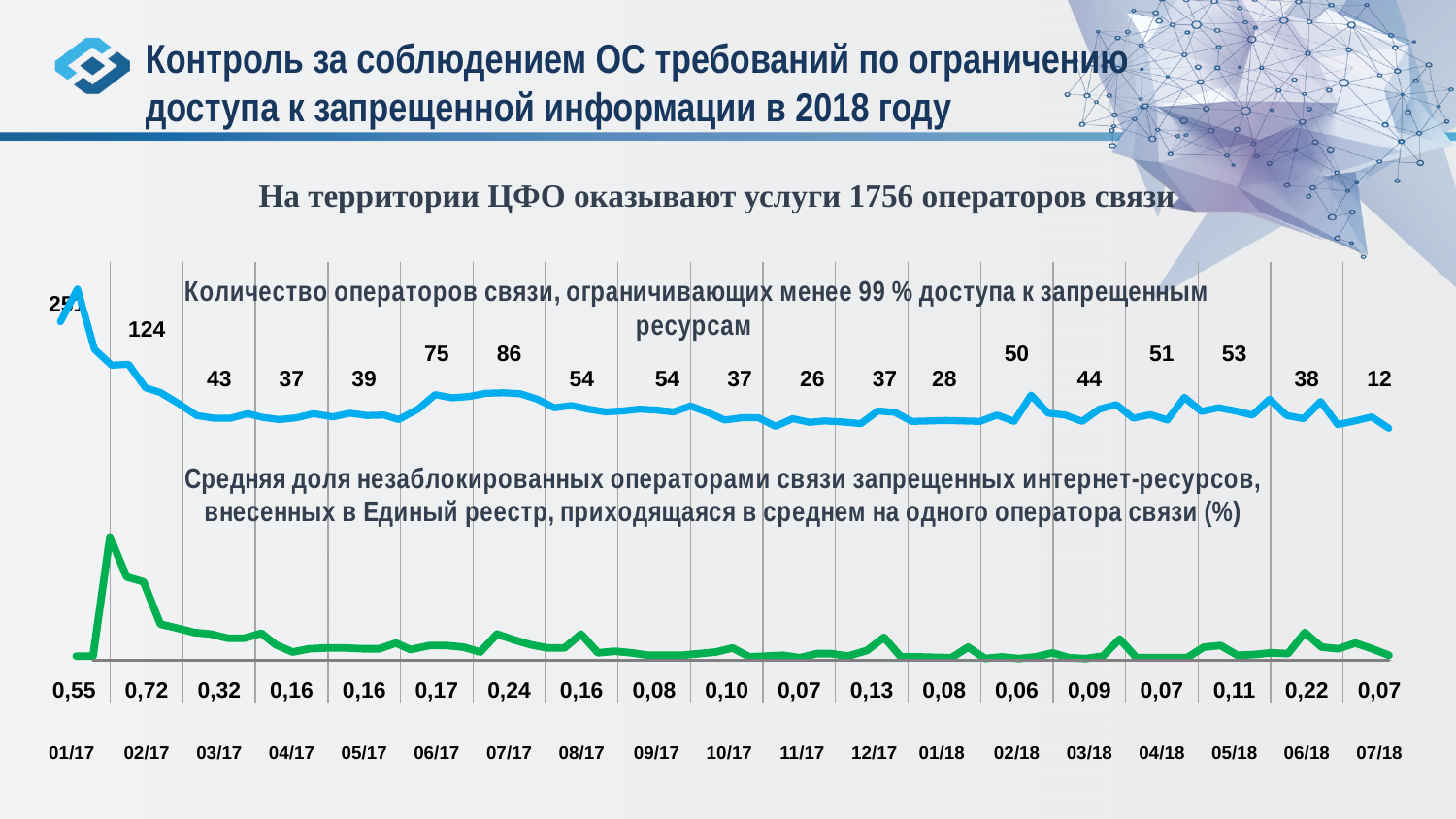
In the upper chart (Количество операторов связи), what is the value for 07/17? 86 In the lower chart (Средняя доля незаблокированных ... ресурсов), which month has the lowest value? 02/18 In the upper chart (Количество операторов связи), what is the difference between the values for 02/17 and 03/17? 81 In the upper chart (Количество операторов связи), which month has the lowest value? 07/18 In the upper chart (Количество операторов связи), which is larger, the value for 06/17 or the value for 07/17? 07/17 In the upper chart (Количество операторов связи), what is the value for 07/18? 12 In the lower chart (Средняя доля незаблокированных ... ресурсов), what is the value for 02/17? 0,72 In the upper chart (Количество операторов связи, ограничивающих менее 99 % доступа), what is the value for 02/17? 124 In the lower chart (Средняя доля незаблокированных ... ресурсов), what is the value for 06/18? 0,22 In the lower chart (Средняя доля незаблокированных ... ресурсов), which month has the highest value? 02/17 How many months (data points) are plotted along the x axis of the charts? 19 What kind of chart is used on the slide to show the number of operators restricting less than 99% of access? line chart